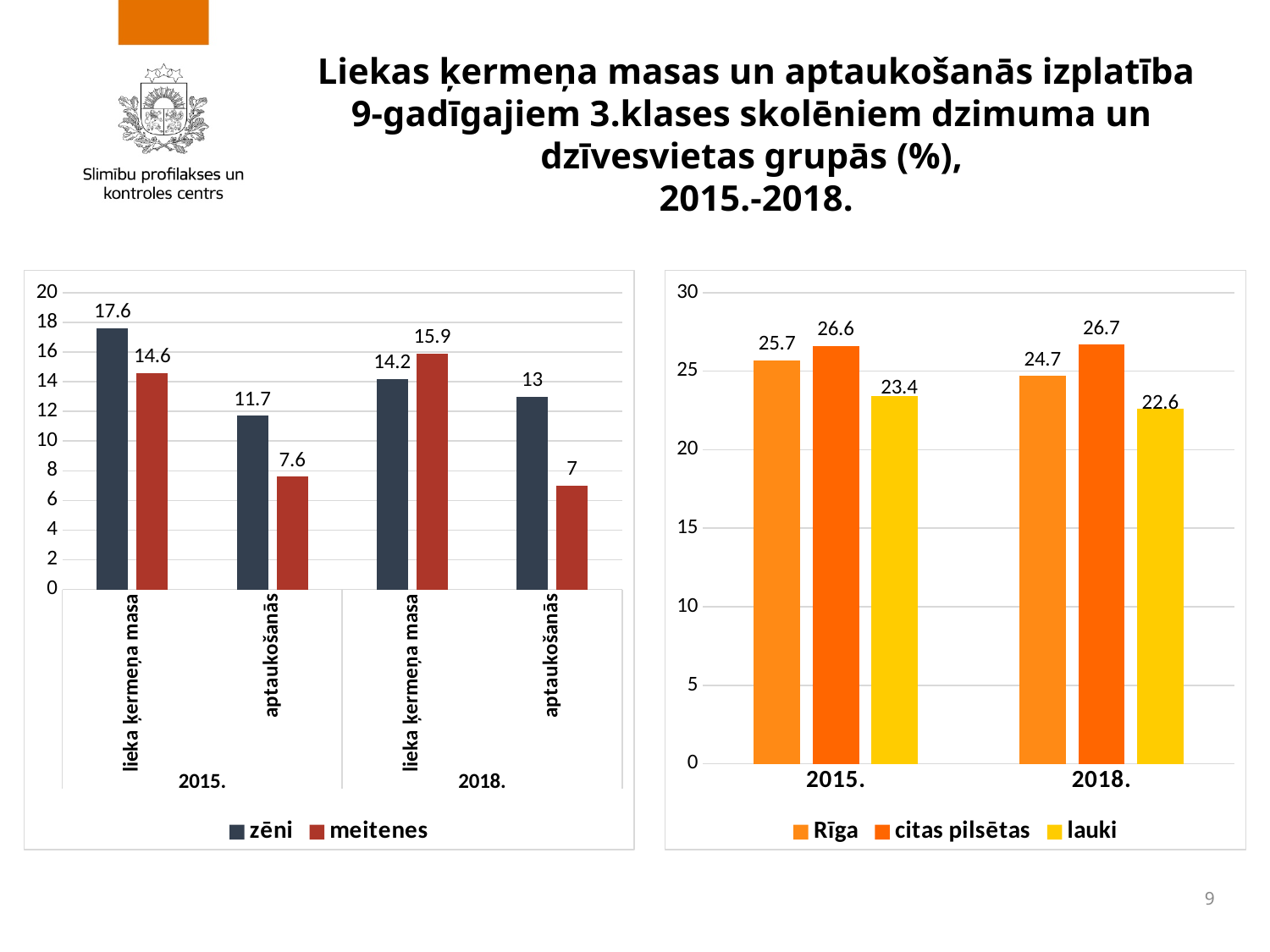
In the left chart, what is the value for meitenes for aptaukošanās in 2018? 7 In the left chart, what is the difference between zēni and meitenes for aptaukošanās in 2015? 4.1 How many series does the legend of the left chart list? 2 In the left chart, what is the value for zēni for lieka ķermeņa masa in 2015? 17.6 In the left chart, which is larger for lieka ķermeņa masa in 2018, zēni or meitenes? meitenes In the right chart, what is the value for lauki in 2015? 23.4 In the right chart, does the value for lauki rise or fall from 2015 to 2018? fall In the right chart, what is the value for citas pilsētas in 2018? 26.7 In the right chart, what is the difference between Rīga in 2015 and Rīga in 2018? 1 What kind of chart is the right chart? bar chart In the right chart, which group has the highest value in 2018? citas pilsētas In the left chart, which bar has the lowest value? meitenes, aptaukošanās 2018